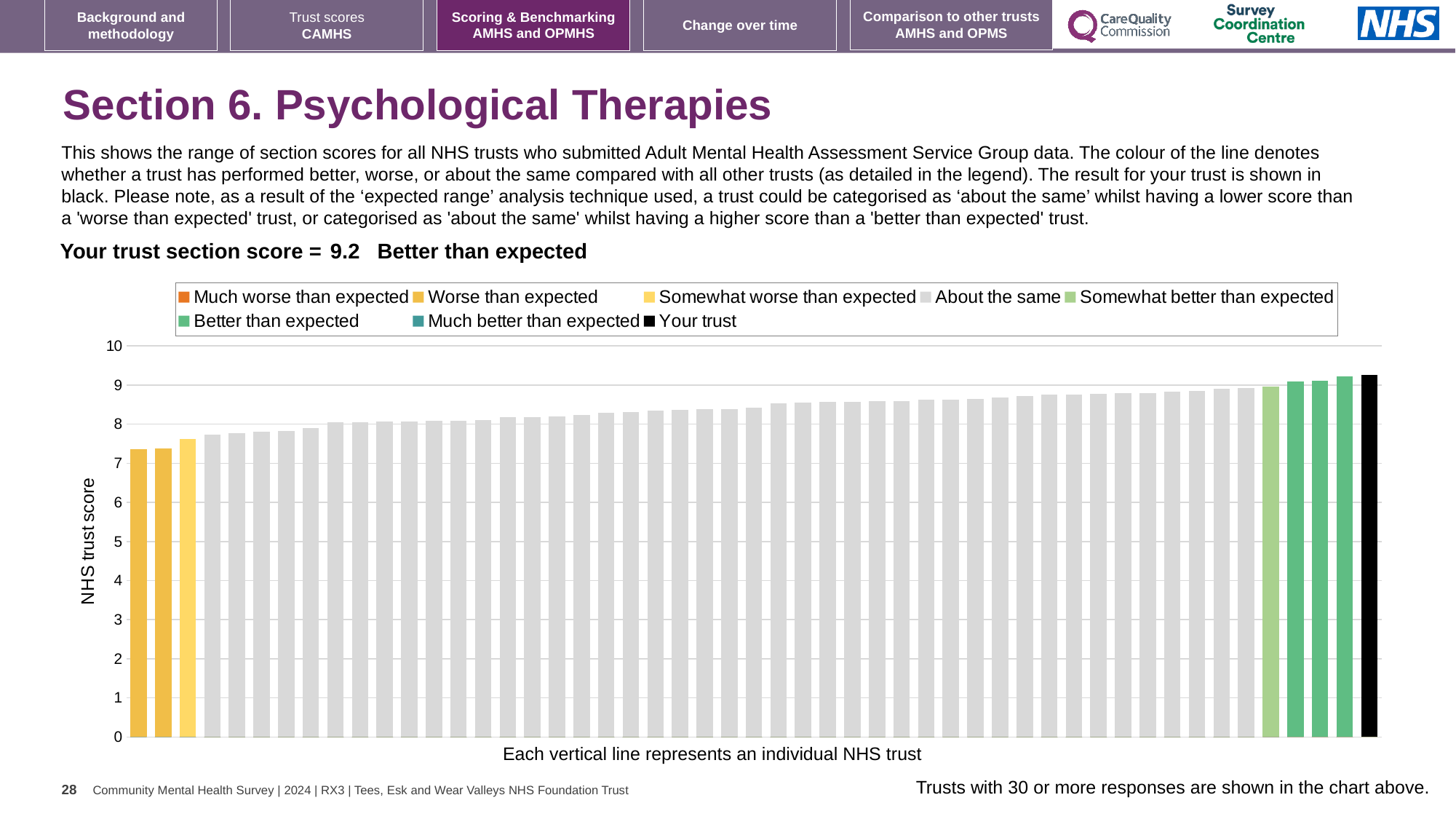
Do the bar values rise or fall from left to right along the x axis? Rise Is the value of the black 'Your trust' bar greater or less than 9? greater Is the value of the leftmost bar greater or less than 8? less What is the title of the vertical axis? NHS trust score What is the section score for your trust shown on the slide? 9.2 What colour is the bar representing your trust? Black Which is larger, the leftmost bar or the rightmost (black) bar? The rightmost (black) bar How many entries does the chart legend list? 8 Is the value of the leftmost bar greater or less than 7? greater What kind of chart is shown on the slide? Bar chart Which category is your trust's section score placed in? Better than expected